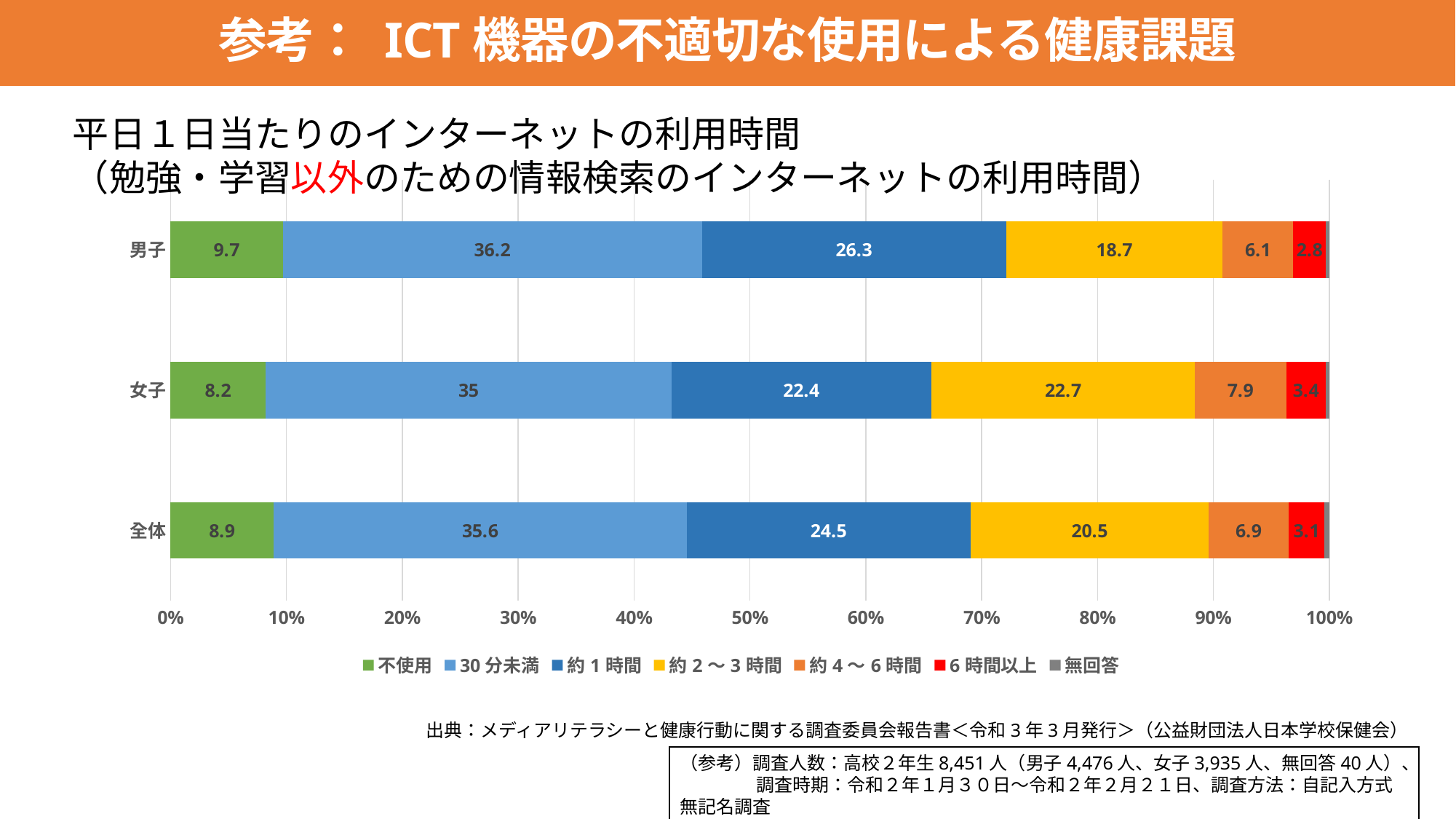
How many categories (bars) are plotted on the chart? 3 What is the value of 約2～3時間 for 女子? 22.7 How many series does the legend list? 7 What is the value of 不使用 for 全体? 8.9 What is the value of 30分未満 for 男子? 36.2 Which legend entry is shown in red? 6時間以上 What type of chart is shown on the slide? Stacked bar chart Which category has the lowest value for 約4～6時間? 男子 What is the difference between the 約2～3時間 values for 女子 and 男子? 4 Which category has the highest value for 約1時間? 男子 What is the value of 6時間以上 for 女子? 3.4 Which is larger: the 不使用 value for 男子 or for 女子? 男子